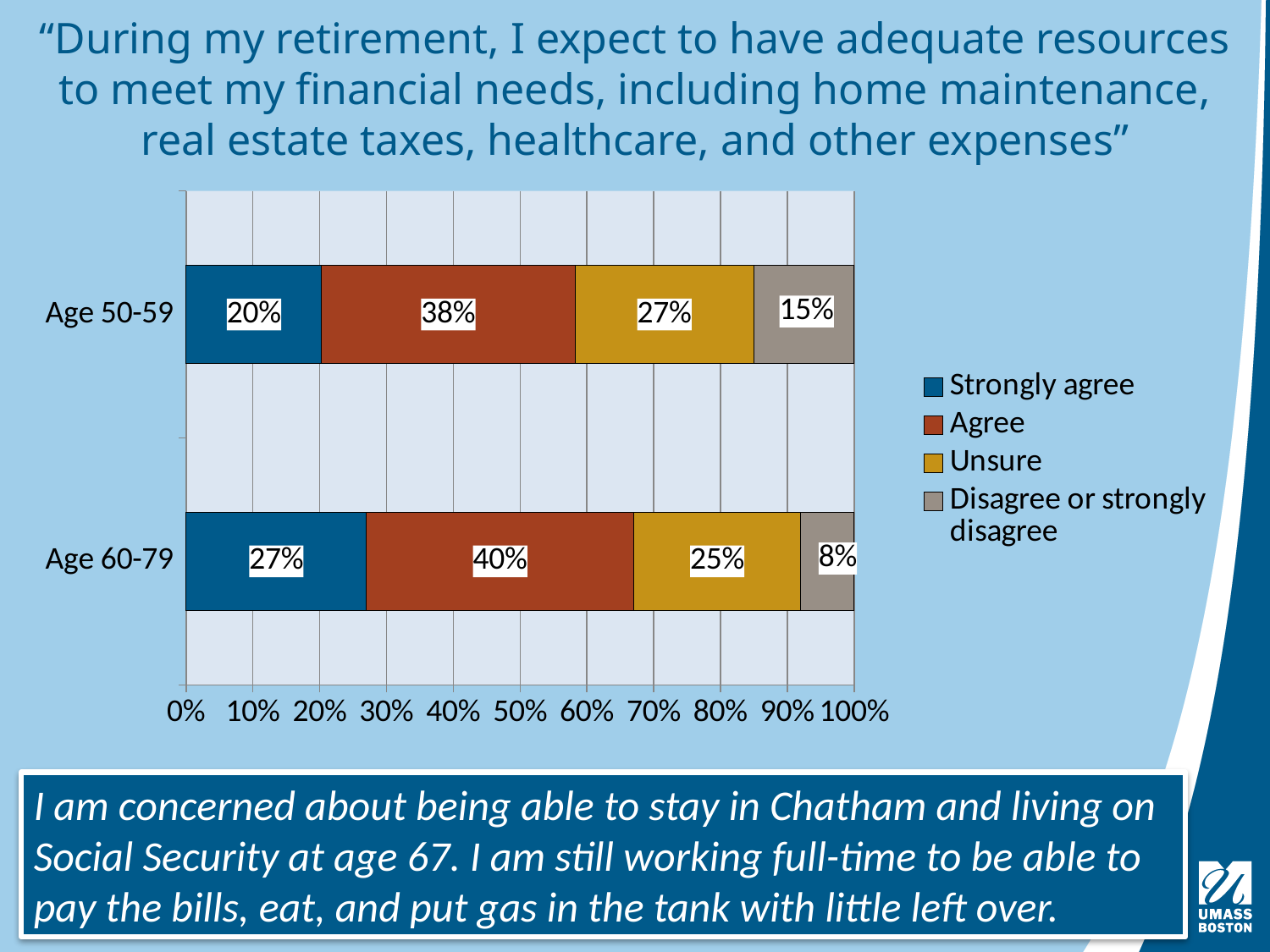
How many series does the legend list? 4 Which age group has the higher share of respondents who strongly agree? Age 60-79 Which age group has the higher share of respondents who disagree or strongly disagree? Age 50-59 What is the difference in the Agree percentage between the Age 60-79 group and the Age 50-59 group? 2% What percentage of the Age 60-79 group agree? 40% What percentage of the Age 60-79 group disagree or strongly disagree? 8% What is the difference in the Disagree or strongly disagree percentage between the Age 50-59 group and the Age 60-79 group? 7% What percentage of the Age 50-59 group strongly agree? 20% Which response category is the smallest for the Age 60-79 group? Disagree or strongly disagree What percentage of the Age 50-59 group are unsure? 27% Which response category is the largest for the Age 50-59 group? Agree What kind of chart is shown on the slide? Stacked bar chart